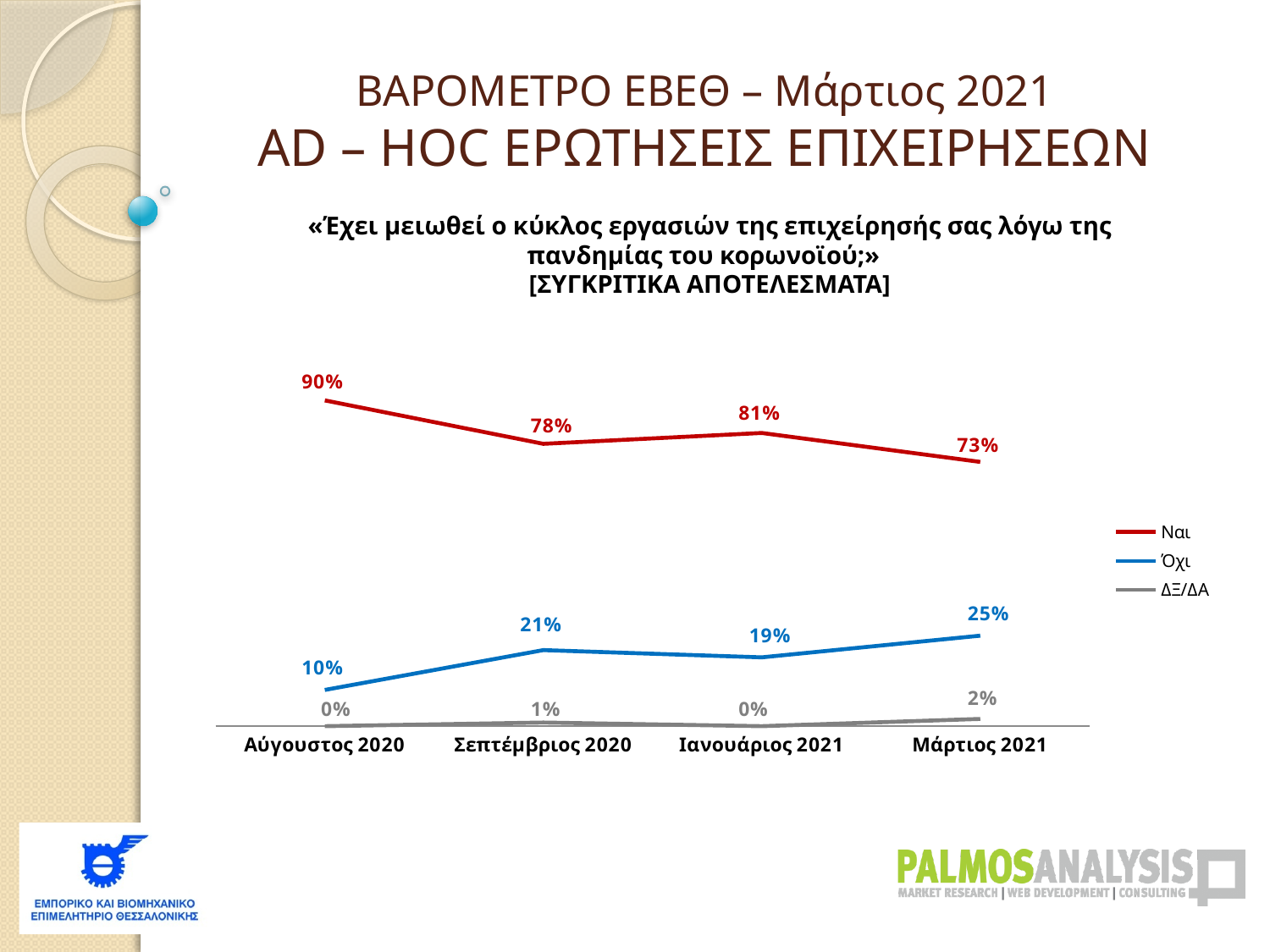
Which is larger: Όχι in Σεπτέμβριος 2020 or Όχι in Ιανουάριος 2021? Σεπτέμβριος 2020 What is the value for ΔΞ/ΔΑ in Σεπτέμβριος 2020? 1% How many time periods are shown on the x axis? 4 How many series does the legend list? 3 What is the value for Ναι in Ιανουάριος 2021? 81% In which period is the Όχι series lowest? Αύγουστος 2020 What colour is the line for the Όχι series? Blue What is the difference between the Ναι values for Αύγουστος 2020 and Μάρτιος 2021? 17% What is the value for Όχι in Μάρτιος 2021? 25% What is the value for Ναι in Αύγουστος 2020? 90% What kind of chart is shown on the slide? Line chart In which period is the Ναι series highest? Αύγουστος 2020